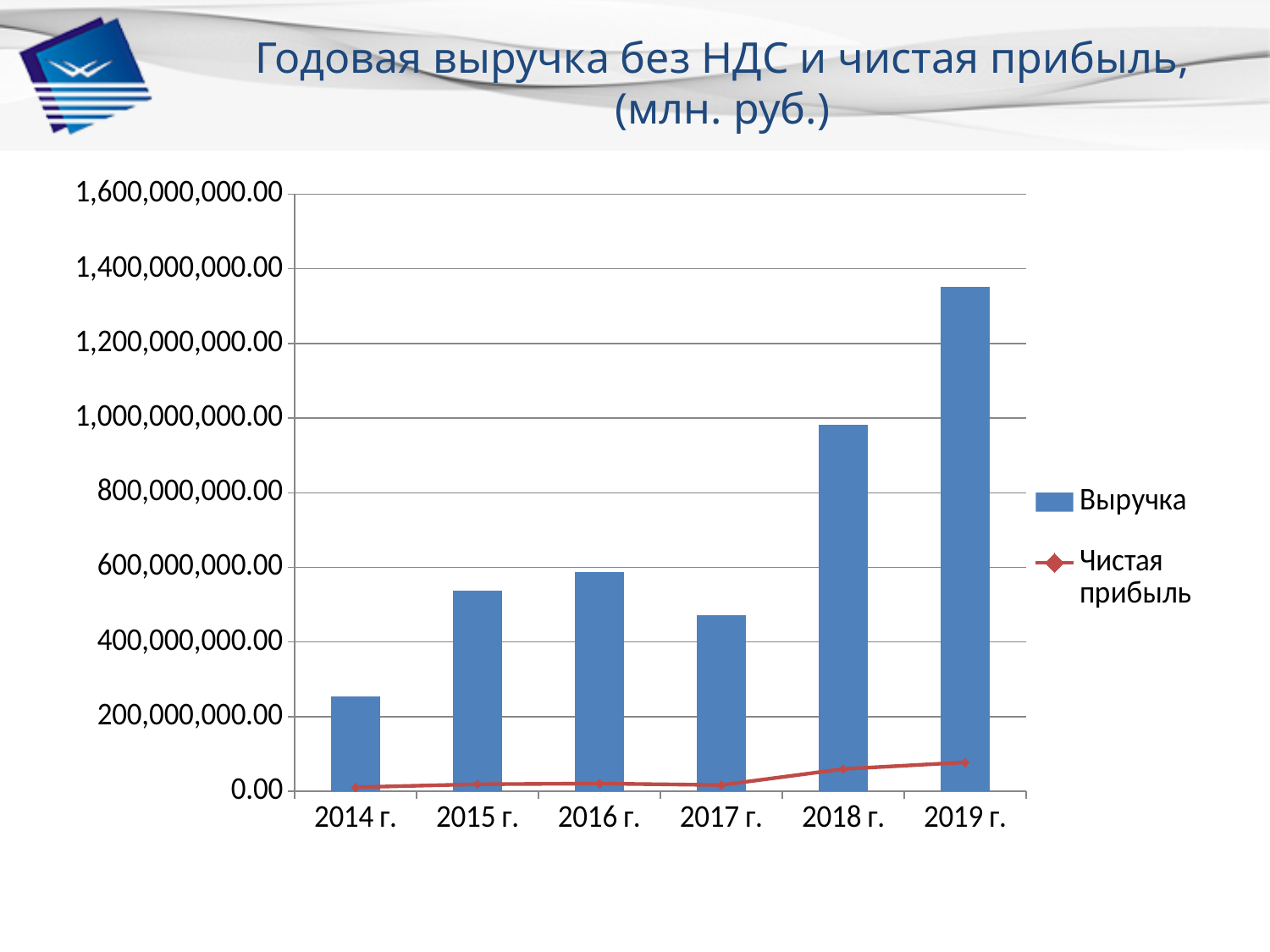
How many years are shown on the x axis of the chart? 6 In which year is Выручка (revenue) the highest? 2019 г. In which year is Выручка (revenue) the lowest? 2014 г. What kind of chart is shown on the slide? A bar chart with a line series overlaid Is the Выручка value for 2017 г. greater or less than 600,000,000.00? less What is the title of the chart on the slide? Годовая выручка без НДС и чистая прибыль, (млн. руб.) Is the Выручка value for 2014 г. greater or less than 200,000,000.00? greater Which series is shown as a red line with markers in the chart? Чистая прибыль Which year has higher Выручка, 2017 г. or 2018 г.? 2018 г. Is the Выручка value for 2019 г. greater or less than 1,200,000,000.00? greater How many series does the chart legend list? 2